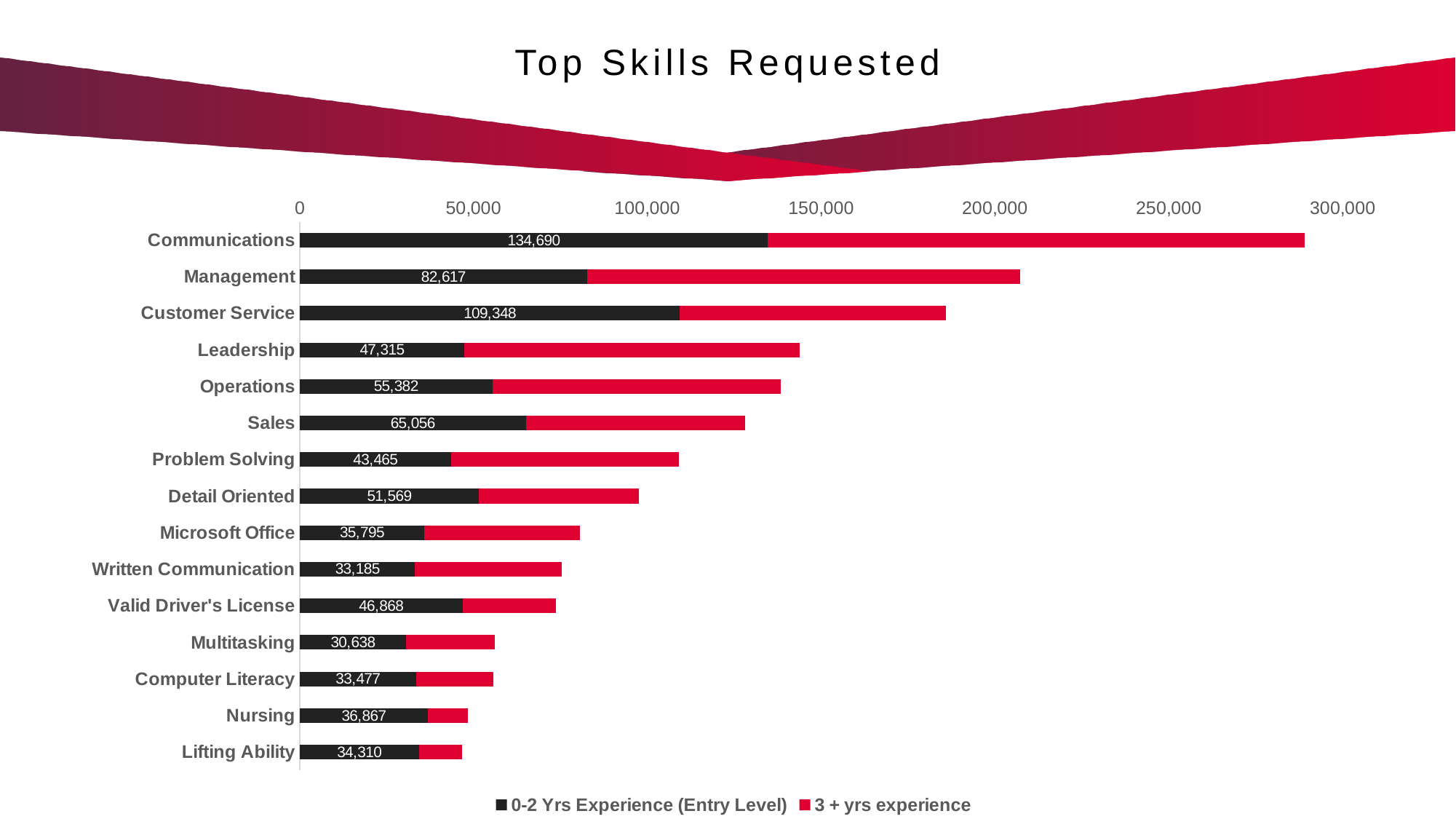
What is the 0-2 Yrs Experience (Entry Level) value for Management? 82,617 What kind of chart is shown on the slide? Stacked bar chart How many series does the legend list? 2 How many skills are listed on the chart? 15 What is the value for Communications in the 0-2 Yrs Experience (Entry Level) series? 134,690 What is the difference between the 0-2 Yrs Experience values for Communications and Customer Service? 25,342 What is the 0-2 Yrs Experience (Entry Level) value for Nursing? 36,867 What is the title of the chart? Top Skills Requested Which skill has the lowest 0-2 Yrs Experience (Entry Level) value? Multitasking Which has the larger 0-2 Yrs Experience (Entry Level) value, Sales or Operations? Sales Is the total bar length for Leadership greater or less than 100,000? greater Which skill has the highest 0-2 Yrs Experience (Entry Level) value? Communications